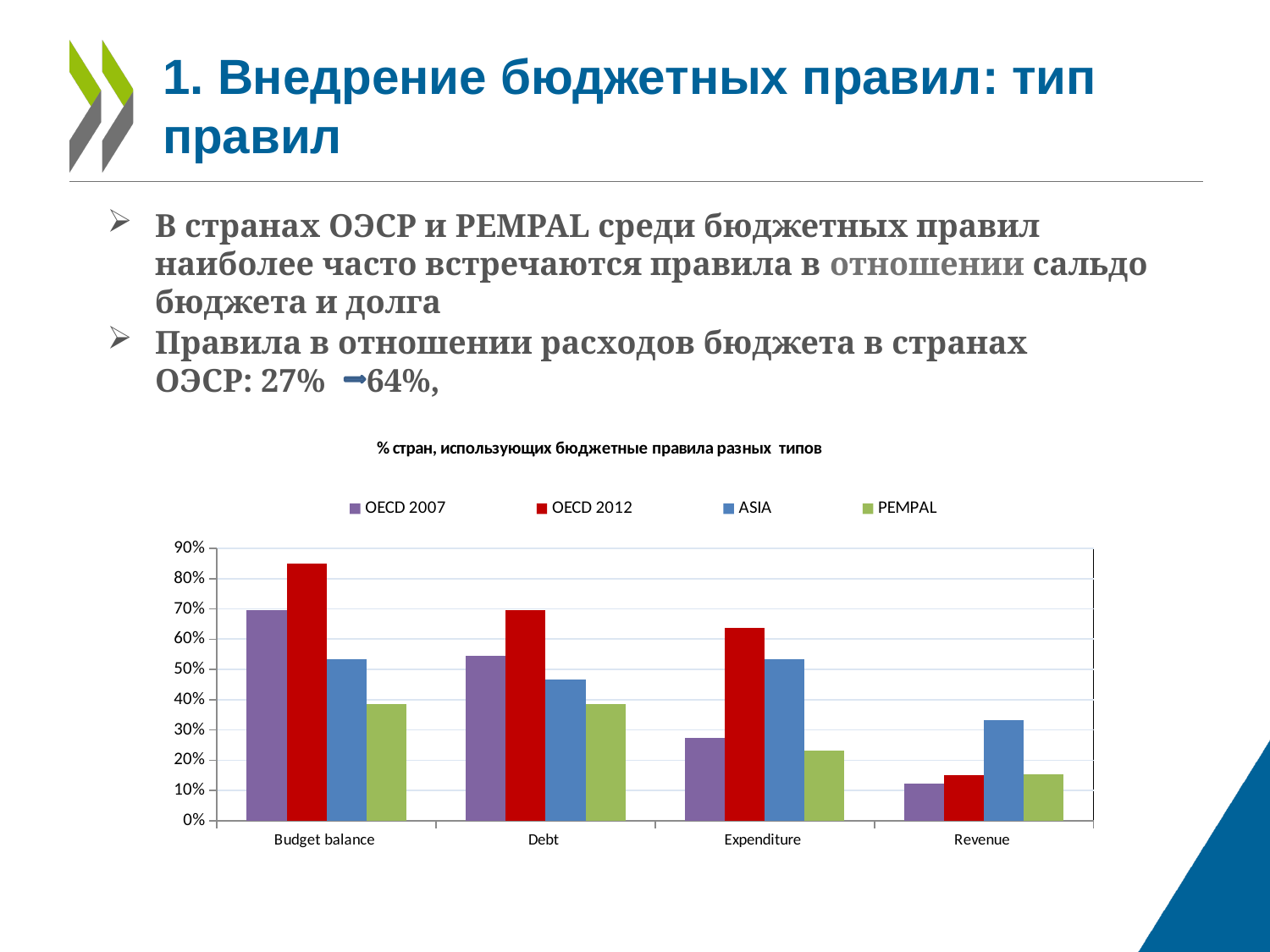
Do the OECD 2007 values rise or fall from Budget balance to Revenue along the x axis? fall What colour are the OECD 2012 bars in the chart? red Is the OECD 2012 value for Budget balance greater or less than 80%? greater How many categories are shown on the x axis of the chart? 4 How many series does the chart legend list? 4 Is the PEMPAL value for Expenditure greater or less than 30%? less Which series has the highest bar for Revenue? ASIA For which category is the OECD 2012 bar the highest? Budget balance Is the ASIA value for Revenue greater or less than 20%? greater For which category is the OECD 2012 bar the lowest? Revenue For Expenditure, which is larger: OECD 2007 or OECD 2012? OECD 2012 What kind of chart is shown on the slide? bar chart